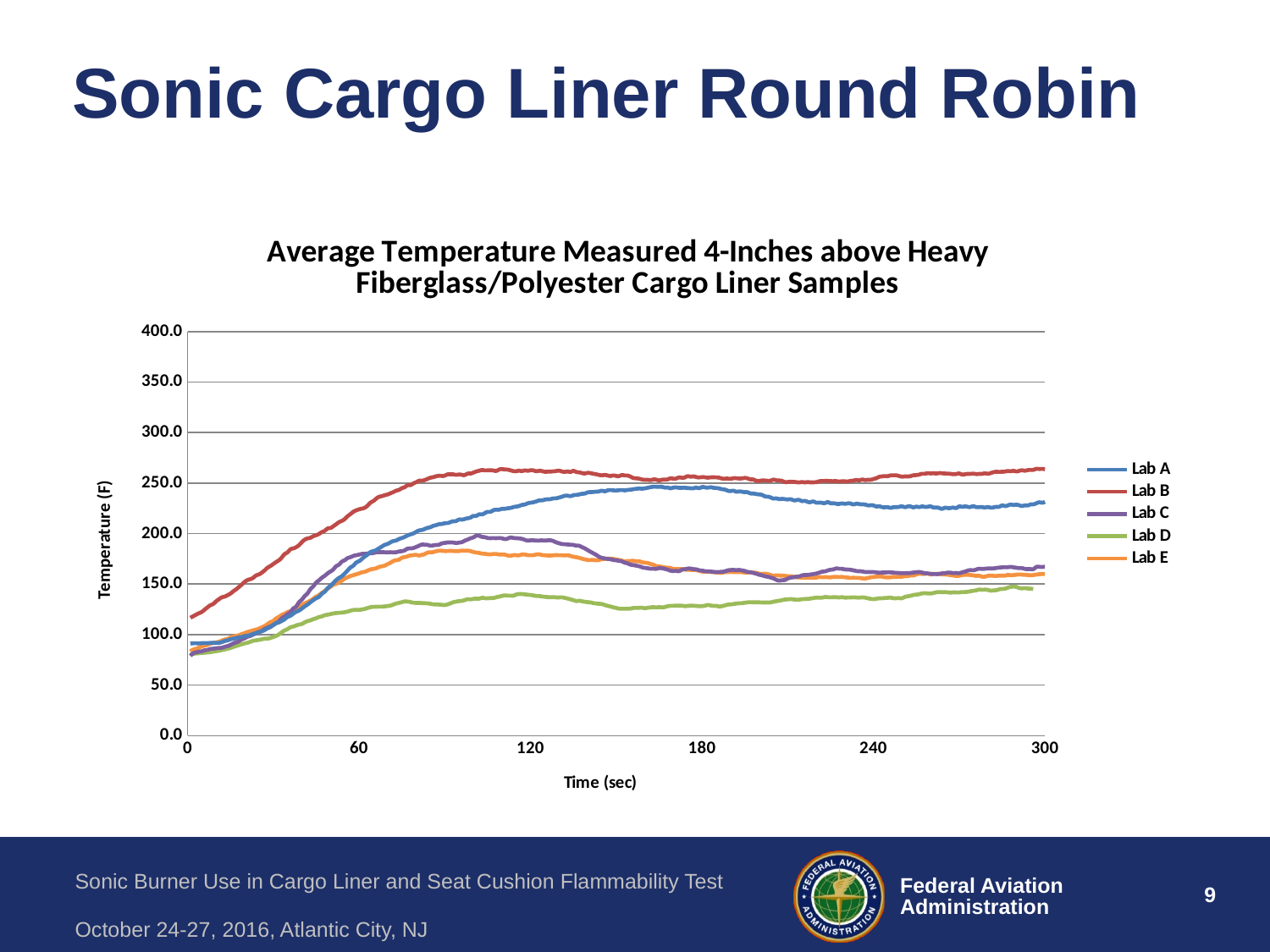
Does the Lab B line rise or fall between 0 and 60 seconds? rise At 240 seconds, which is larger, the value for Lab A or the value for Lab C? Lab A Is the value for Lab A at 300 seconds greater or less than 200.0? greater What is the title of the chart? Average Temperature Measured 4-Inches above Heavy Fiberglass/Polyester Cargo Liner Samples How many series does the legend list? 5 Which lab has the highest temperature at 300 seconds? Lab B Is the value for Lab B at 120 seconds greater or less than 250.0? greater Is the value for Lab D at 180 seconds greater or less than 150.0? less What is the label of the vertical axis? Temperature (F) What kind of chart is shown on the slide? line chart Which lab has the highest temperature at 120 seconds? Lab B Which lab has the lowest temperature at 120 seconds? Lab D